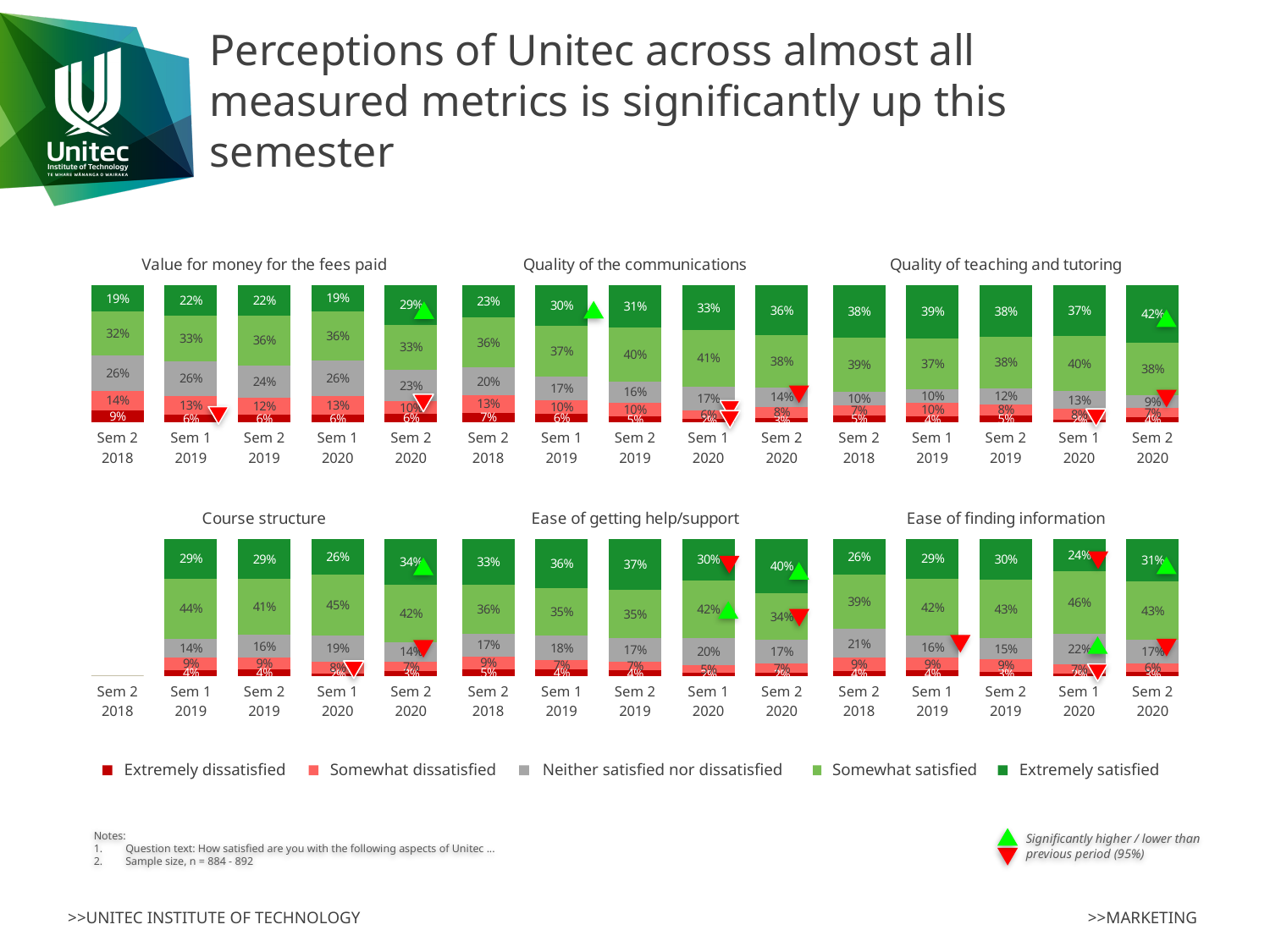
In the 'Ease of finding information' chart, which period has the highest Somewhat satisfied value? Sem 1 2020 In the 'Quality of teaching and tutoring' chart, which period has the lowest Extremely satisfied value? Sem 1 2020 How many series does the legend list? 5 In the 'Quality of the communications' chart, what is the difference between the Extremely satisfied values for Sem 2 2020 and Sem 2 2018? 13% What kind of chart is used for 'Course structure'? Stacked bar chart In the 'Value for money for the fees paid' chart, what is the Extremely satisfied value for Sem 2 2020? 29% In the 'Quality of teaching and tutoring' chart, what is the Extremely satisfied value for Sem 2 2020? 42% In the 'Ease of getting help/support' chart, is the Extremely satisfied value larger for Sem 2 2020 or Sem 1 2020? Sem 2 2020 In the 'Ease of finding information' chart, what is the Neither satisfied nor dissatisfied value for Sem 2 2018? 21% In the 'Course structure' chart, what is the Somewhat satisfied value for Sem 1 2020? 45% In the 'Quality of the communications' chart, what is the Somewhat satisfied value for Sem 1 2020? 41% In the 'Value for money for the fees paid' chart, which period has the highest Extremely satisfied value? Sem 2 2020